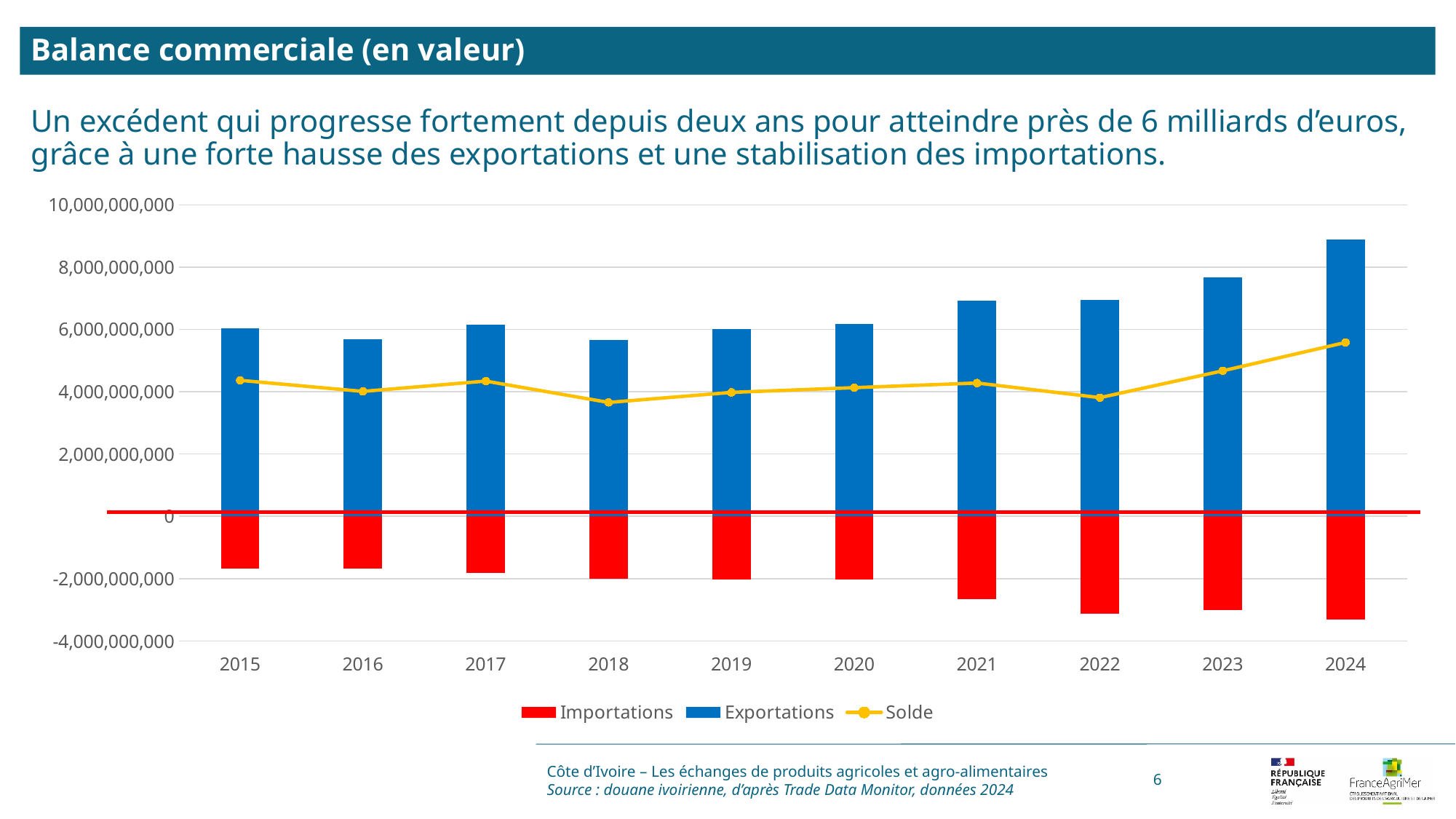
Which year has the highest Solde value? 2024 How many years are shown on the x axis of the chart? 10 Which is larger, the Exportations value for 2023 or for 2022? 2023 Is the Exportations value for 2024 greater or less than 8,000,000,000? greater How many series does the chart legend list? 3 Is the Solde value for 2018 greater or less than 4,000,000,000? less Is the Exportations value for 2016 greater or less than 6,000,000,000? less What colour are the Exportations bars in the chart? Blue Does the Solde line rise or fall from 2022 to 2024? It rises What kind of chart is shown on the slide? A combined bar and line chart Which year has the highest Exportations value? 2024